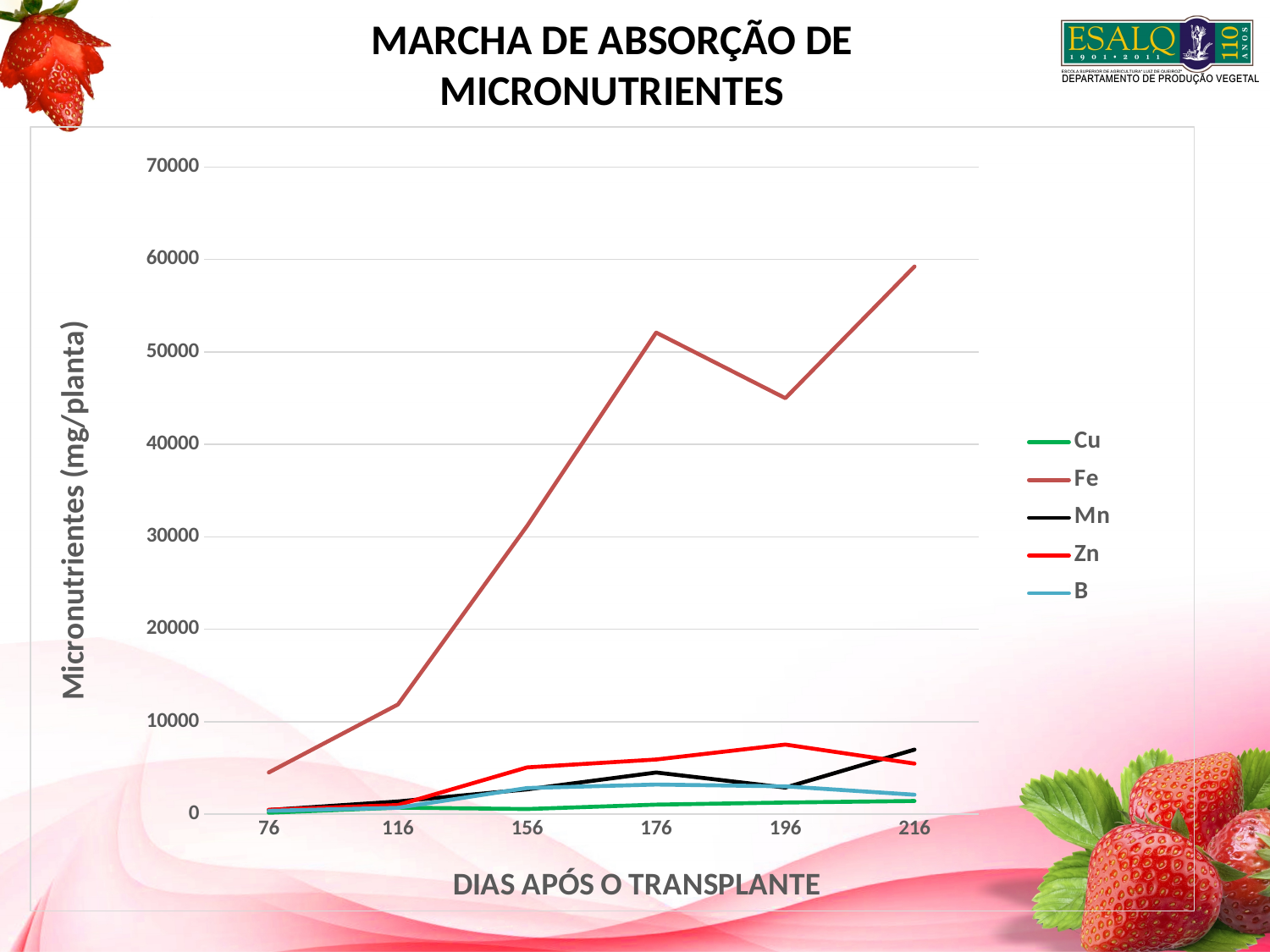
Is the value for Fe at 116 days greater or less than 10000? greater What is the label of the y axis? Micronutrientes (mg/planta) Is the value for Fe at 216 days greater or less than 50000? greater Which series is drawn in green? Cu Which is larger at 196 days, Zn or Mn? Zn What kind of chart is shown on the slide? line chart How many series does the legend list? 5 Is the value for Fe at 196 days greater or less than 50000? less Which series has the highest value at 216 days after transplant? Fe Which series has the lowest value at 196 days after transplant? Cu How many points are on the x axis (days after transplant)? 6 Does the Fe line rise or fall between 76 and 176 days after transplant? rise